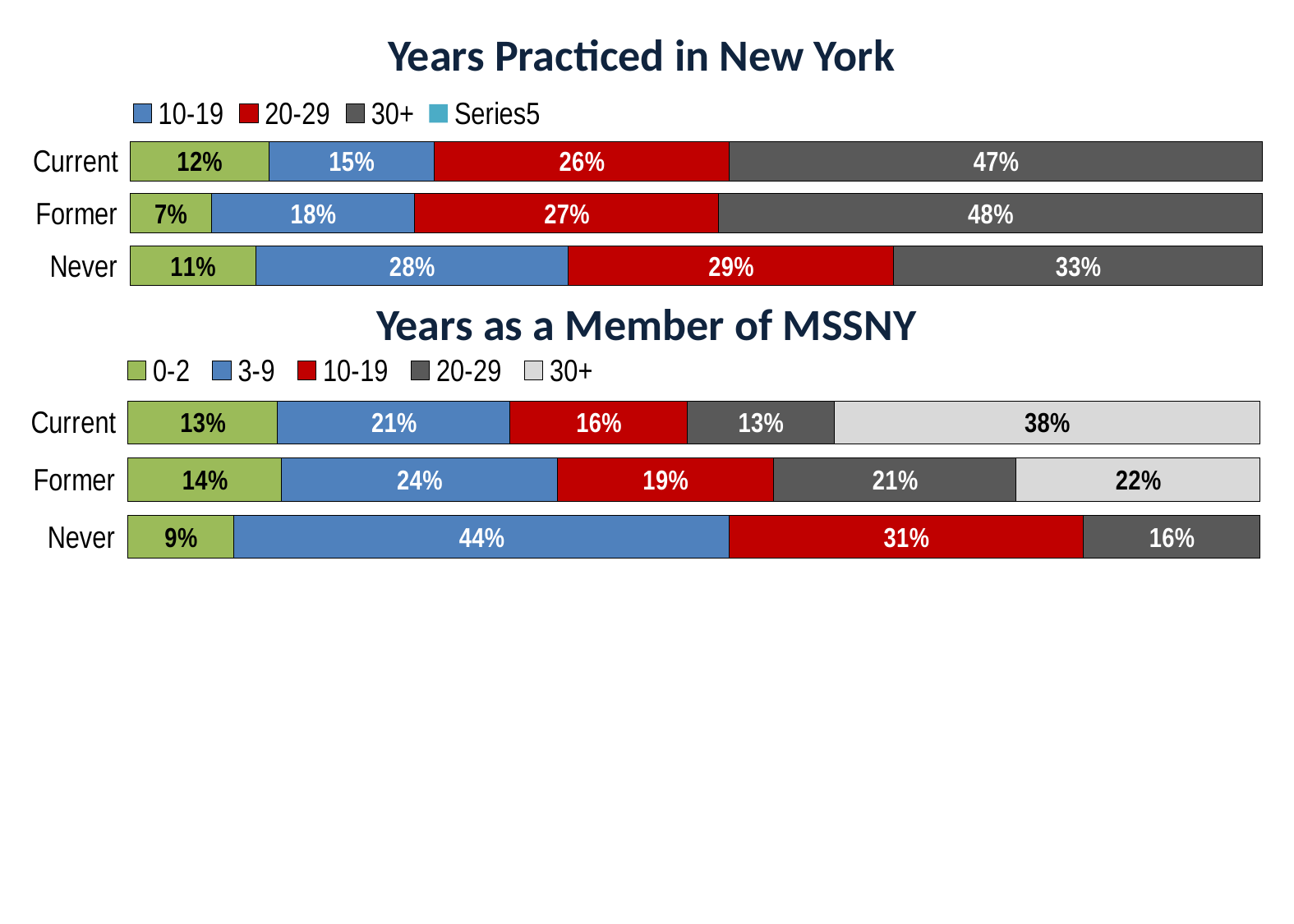
What type of chart is the 'Years Practiced in New York' chart? Stacked bar chart In the 'Years as a Member of MSSNY' chart, is the 10-19 value larger for Former or for Never? Never In the 'Years Practiced in New York' chart, what is the difference between the 30+ values for Former and Never? 15% In the 'Years as a Member of MSSNY' chart, what is the 30+ value for Current? 38% In the 'Years Practiced in New York' chart, what is the 20-29 value for Never? 29% In the 'Years Practiced in New York' chart, which category has the lowest 10-19 value? Current How many series does the legend of the 'Years as a Member of MSSNY' chart list? 5 In the 'Years Practiced in New York' chart, which category has the highest 30+ value? Former In the 'Years as a Member of MSSNY' chart, which category has the highest 0-2 value? Former In the 'Years Practiced in New York' chart, what is the 30+ value for Current? 47% In the 'Years as a Member of MSSNY' chart, what is the difference between the 30+ values for Current and Former? 16% In the 'Years as a Member of MSSNY' chart, what is the 3-9 value for Never? 44%